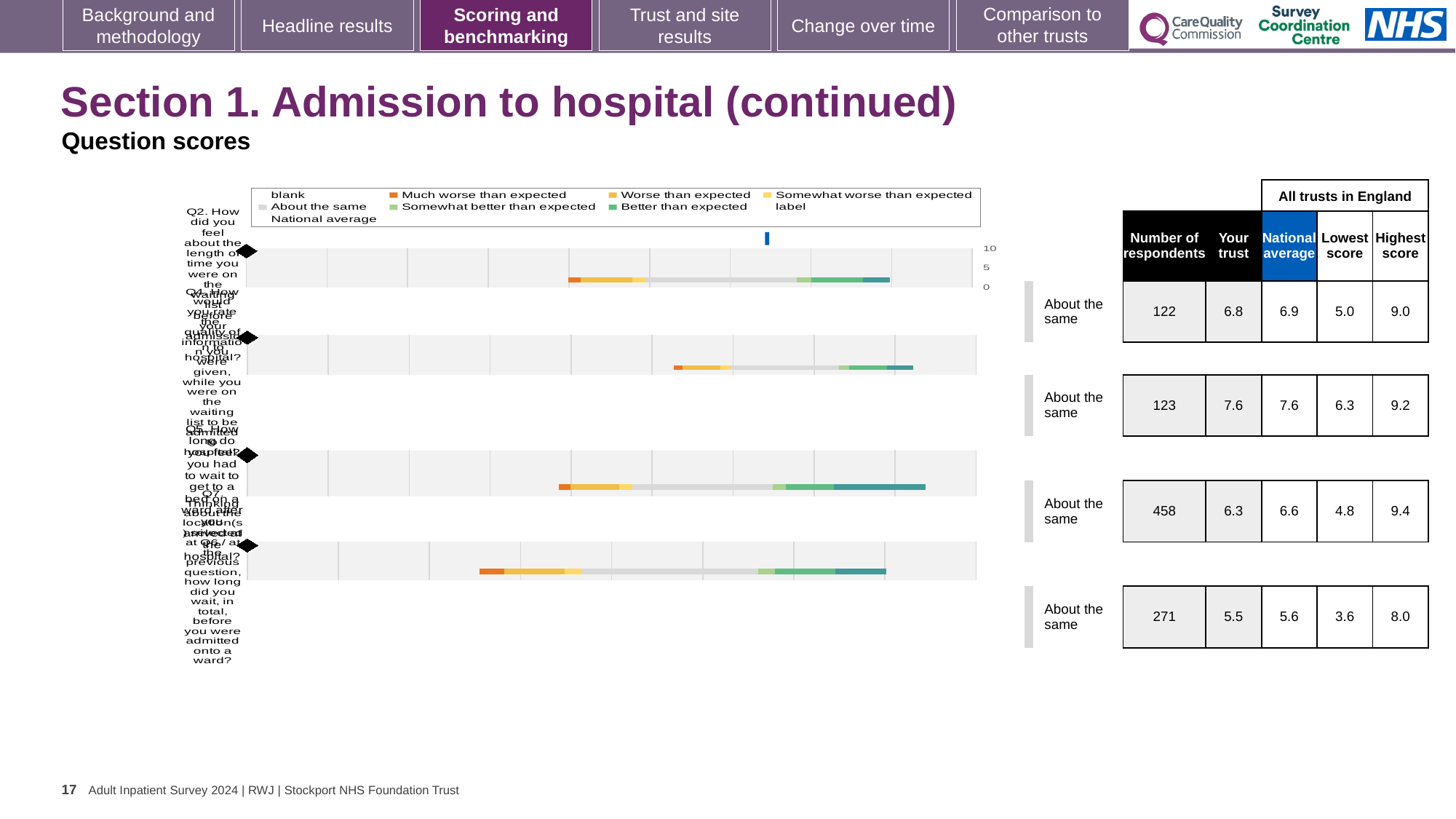
In the table next to the chart, what is the number of respondents for the first row? 122 What is the maximum value shown on the chart's score axis? 10 In the third row of the table, which is larger: the 'Your trust' score or the national average? National average In the table next to the chart, what is the 'Your trust' score for the second row? 7.6 Which row in the table has the smallest number of respondents? the first row (122) What benchmark label is shown for each of the four question rows? About the same In the table next to the chart, what is the national average for the fourth row? 5.6 What kind of chart is shown on the slide? bar chart How many question rows (bars) are plotted in the chart? 4 In the table next to the chart, what is the highest score for the third row? 9.4 Which row in the table has the largest number of respondents? the third row (458) In the first row of the table, what is the difference between the highest score and the lowest score? 4.0